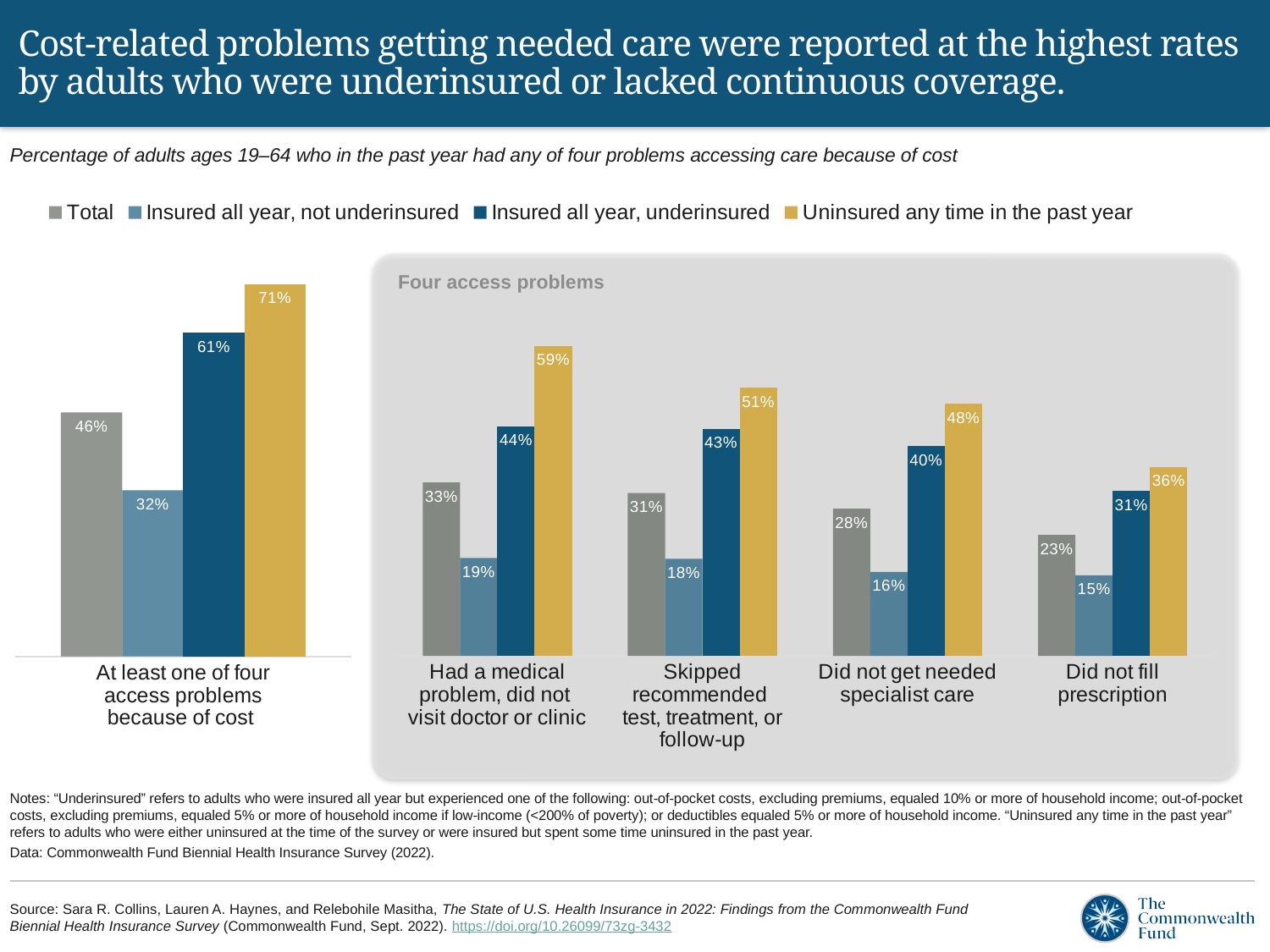
What kind of chart is shown on the slide? Bar chart What is the Total value for 'Skipped recommended test, treatment, or follow-up'? 31% Which series is shown in yellow in the legend? Uninsured any time in the past year Which category has the lowest Total value? Did not fill prescription What is the difference between the Total value for 'At least one of four access problems because of cost' and the Total value for 'Did not fill prescription'? 23 percentage points What is the difference between the 'Uninsured any time in the past year' and 'Insured all year, not underinsured' values for 'Had a medical problem, did not visit doctor or clinic'? 40 percentage points What percentage of adults who were uninsured any time in the past year had at least one of four access problems because of cost? 71% In the 'Did not get needed specialist care' category, which is larger: the value for 'Insured all year, underinsured' or the Total value? Insured all year, underinsured Which category has the highest value for the 'Insured all year, not underinsured' series? At least one of four access problems because of cost What is the value for 'Insured all year, underinsured' in the 'Did not fill prescription' category? 31% How many series does the legend list? 4